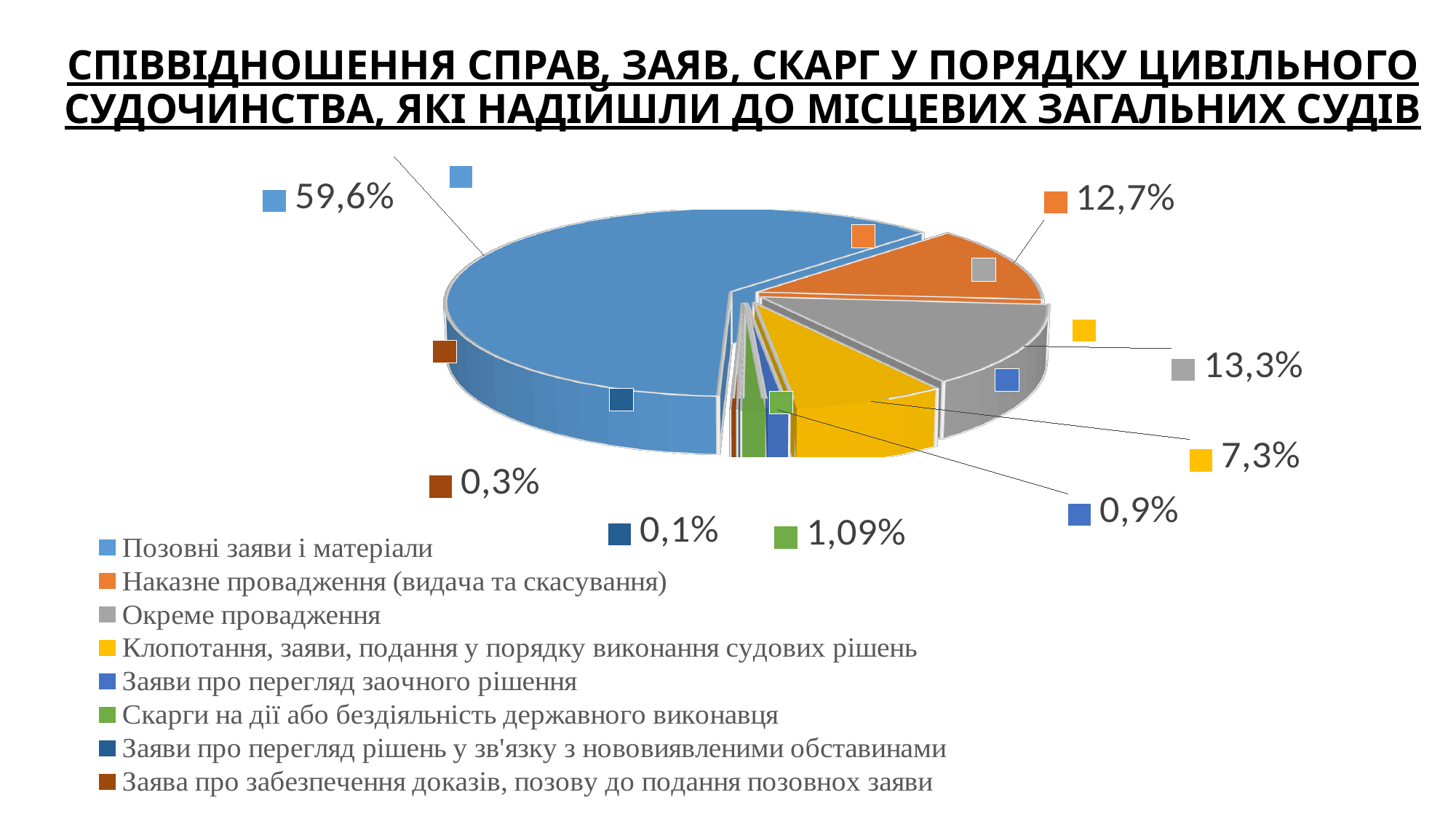
What is the value shown for "Скарги на дії або бездіяльність державного виконавця"? 1,09% How many categories does the legend list? 8 What kind of chart is shown on the slide? pie chart What is the value shown for "Заяви про перегляд рішень у зв'язку з нововиявленими обставинами"? 0,1% What share of the pie is labelled for "Позовні заяви і матеріали"? 59,6% Which category has the largest share of the pie? Позовні заяви і матеріали What is the value shown for "Наказне провадження (видача та скасування)"? 12,7% What is the value shown for "Окреме провадження"? 13,3% Which category has the smallest share of the pie? Заяви про перегляд рішень у зв'язку з нововиявленими обставинами What is the value shown for "Клопотання, заяви, подання у порядку виконання судових рішень"? 7,3% Which is larger: the share for "Окреме провадження" or for "Наказне провадження (видача та скасування)"? Окреме провадження What is the difference between the shares for "Позовні заяви і матеріали" and "Окреме провадження"? 46,3%